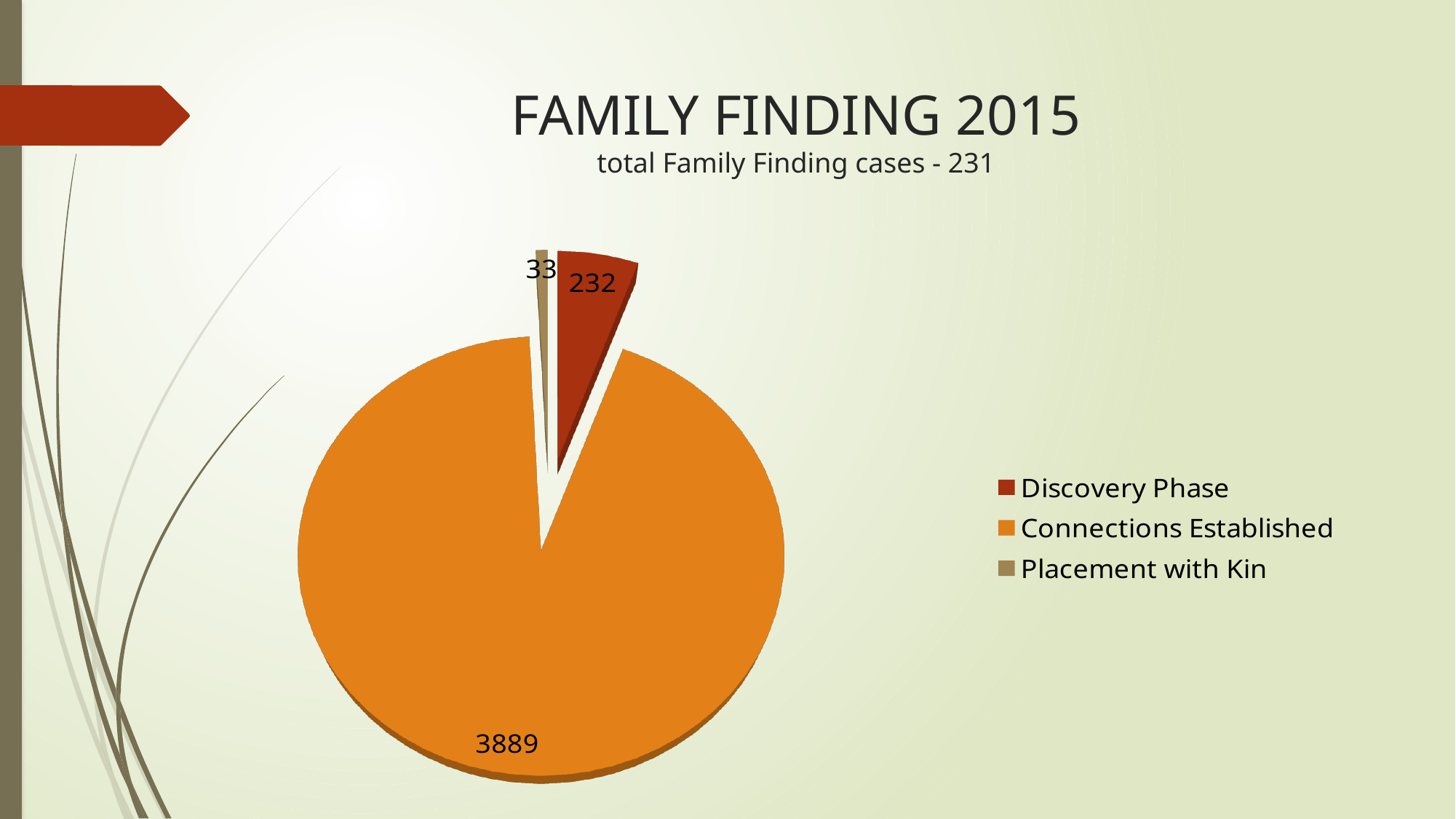
What is the title of the chart slide? FAMILY FINDING 2015 How many categories does the pie chart have? 3 What is the difference between the values for Connections Established and Discovery Phase? 3657 What is the value for Connections Established? 3889 Which category has the largest slice of the pie? Connections Established What kind of chart is shown on the slide? pie chart What is the value for Placement with Kin? 33 What is the value for Discovery Phase? 232 What is the sum of all three slice values in the pie chart? 4154 What is the difference between the values for Discovery Phase and Placement with Kin? 199 Which category has the smallest slice of the pie? Placement with Kin Which is larger, Discovery Phase or Placement with Kin? Discovery Phase